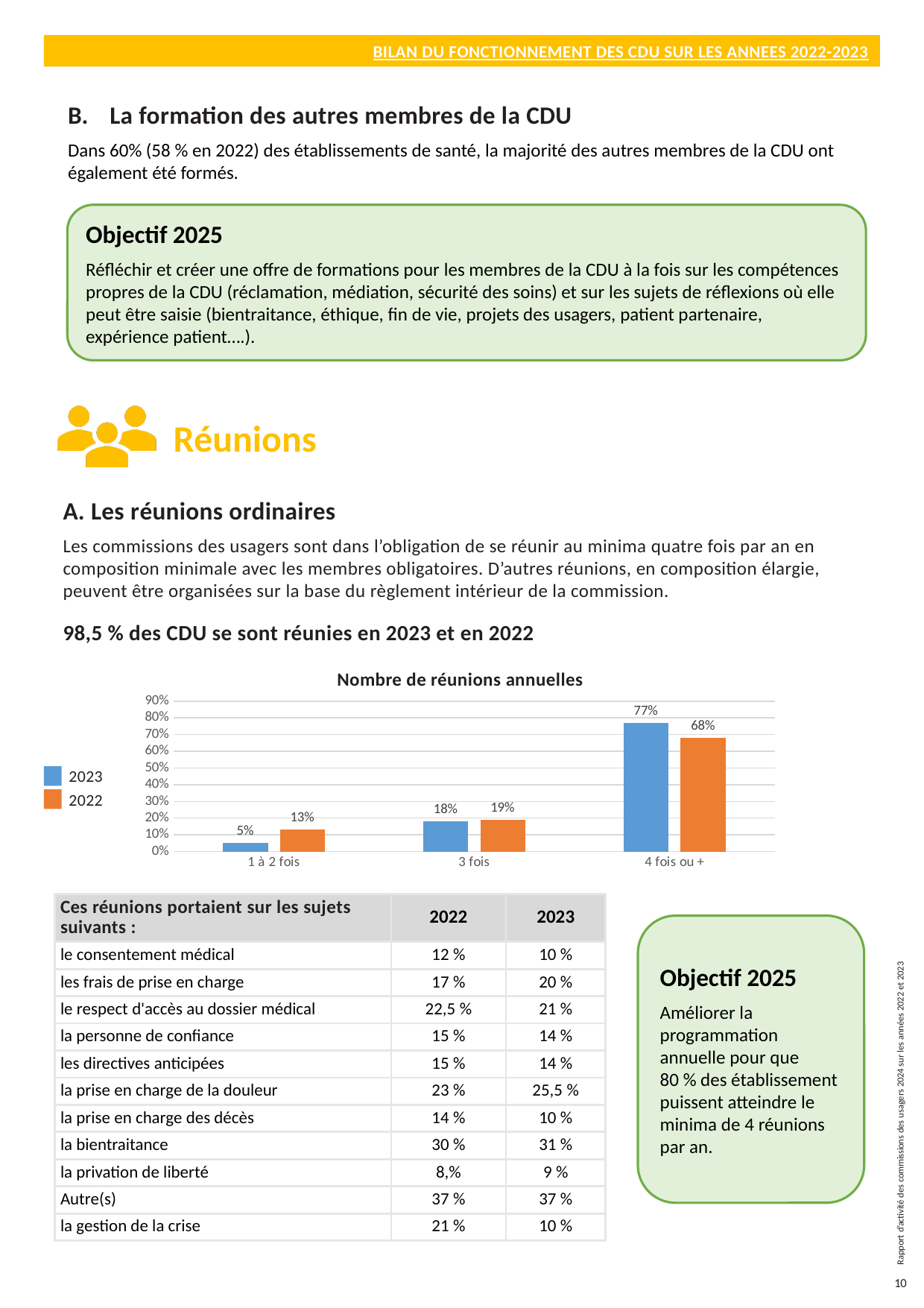
What is the value for 2022 in the '3 fois' category? 19% Which colour represents the 2022 series in the chart? orange Which category has the highest value for the 2023 series? 4 fois ou + Which category has the lowest value for the 2022 series? 1 à 2 fois In the '1 à 2 fois' category, which series has the larger value, 2023 or 2022? 2022 What is the value for 2023 in the '4 fois ou +' category? 77% What type of chart is shown? bar chart What is the difference between the 2023 and 2022 values in the '4 fois ou +' category? 9% How many categories are shown on the x axis of the chart? 3 What is the title of the chart? Nombre de réunions annuelles How many series does the legend list? 2 What is the value for 2022 in the '1 à 2 fois' category? 13%